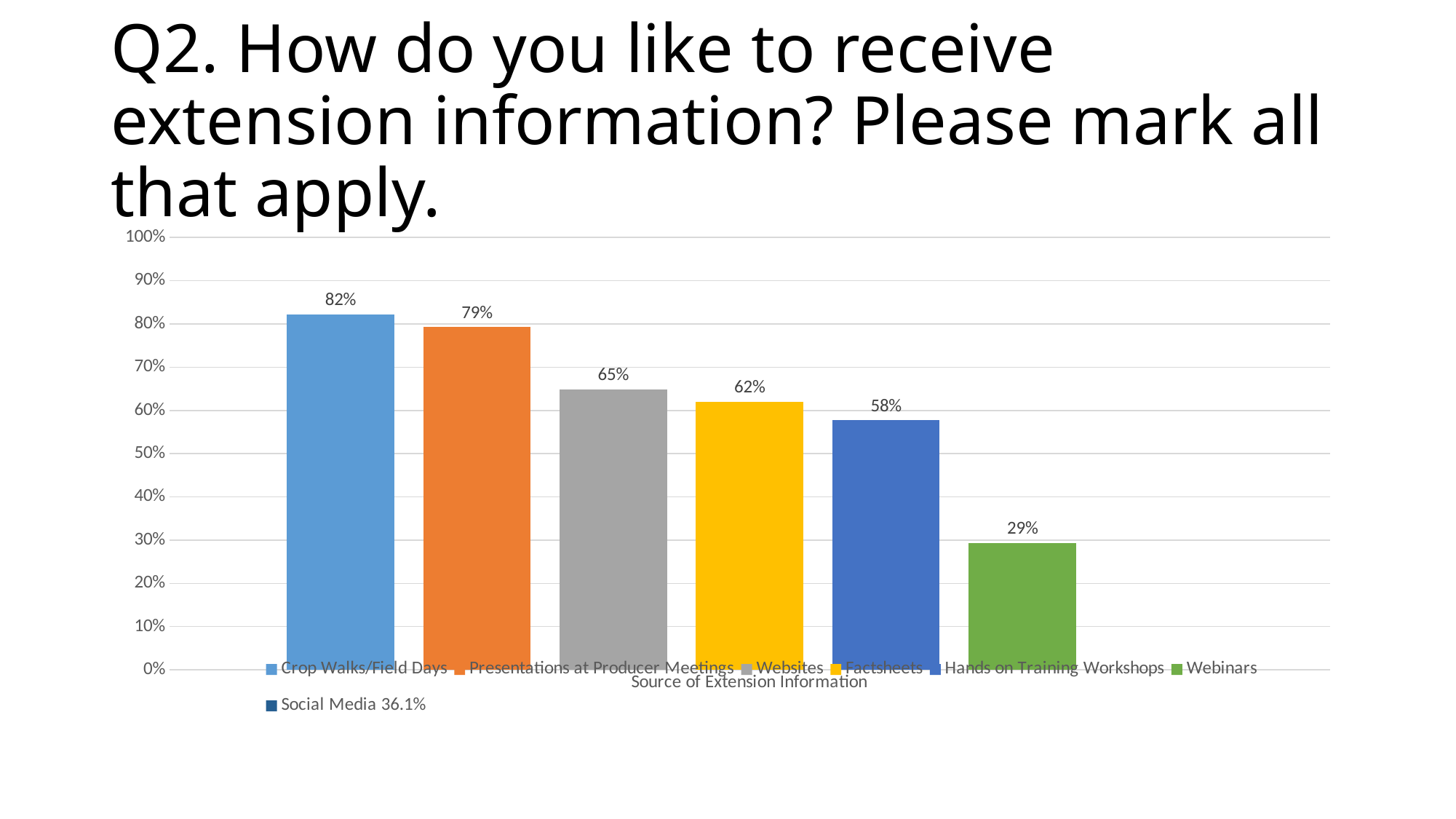
What is the difference between the values for Factsheets and Webinars? 33% What is the value for Crop Walks/Field Days? 82% Which source of extension information has the highest value? Crop Walks/Field Days Which is larger, the value for Websites or the value for Factsheets? Websites What is the value for Websites? 65% Which plotted source of extension information has the lowest value? Webinars What is the x-axis title of the chart? Source of Extension Information What is the value for Hands on Training Workshops? 58% What is the difference between the values for Crop Walks/Field Days and Presentations at Producer Meetings? 3% What is the value for Webinars? 29% How many bars are plotted on the chart? 6 What kind of chart is shown on the slide? Bar chart